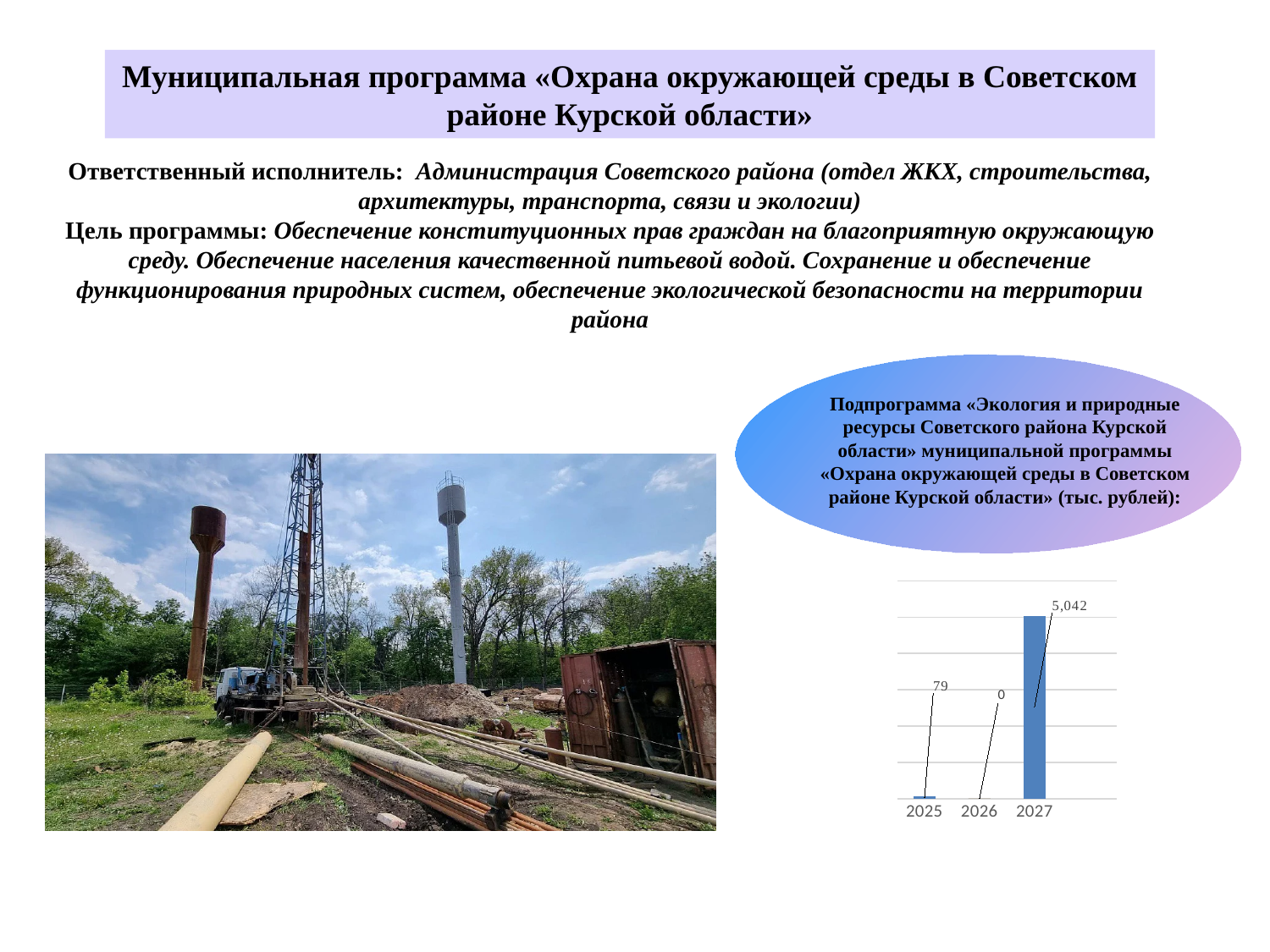
In what units are the chart values given, according to the text above the chart? тыс. рублей How many years are shown on the x axis of the chart? 3 What is the value for 2026 in the chart? 0 Which is larger, the value for 2025 or the value for 2027? 2027 What is the difference between the values for 2027 and 2025? 4,963 Do the values rise or fall from 2026 to 2027? rise Which year has the lowest value in the chart? 2026 What kind of chart is shown on the slide? bar chart Which year has the highest value in the chart? 2027 What is the value for 2025 in the chart? 79 What is the difference between the values for 2025 and 2026? 79 What is the value for 2027 in the chart? 5,042